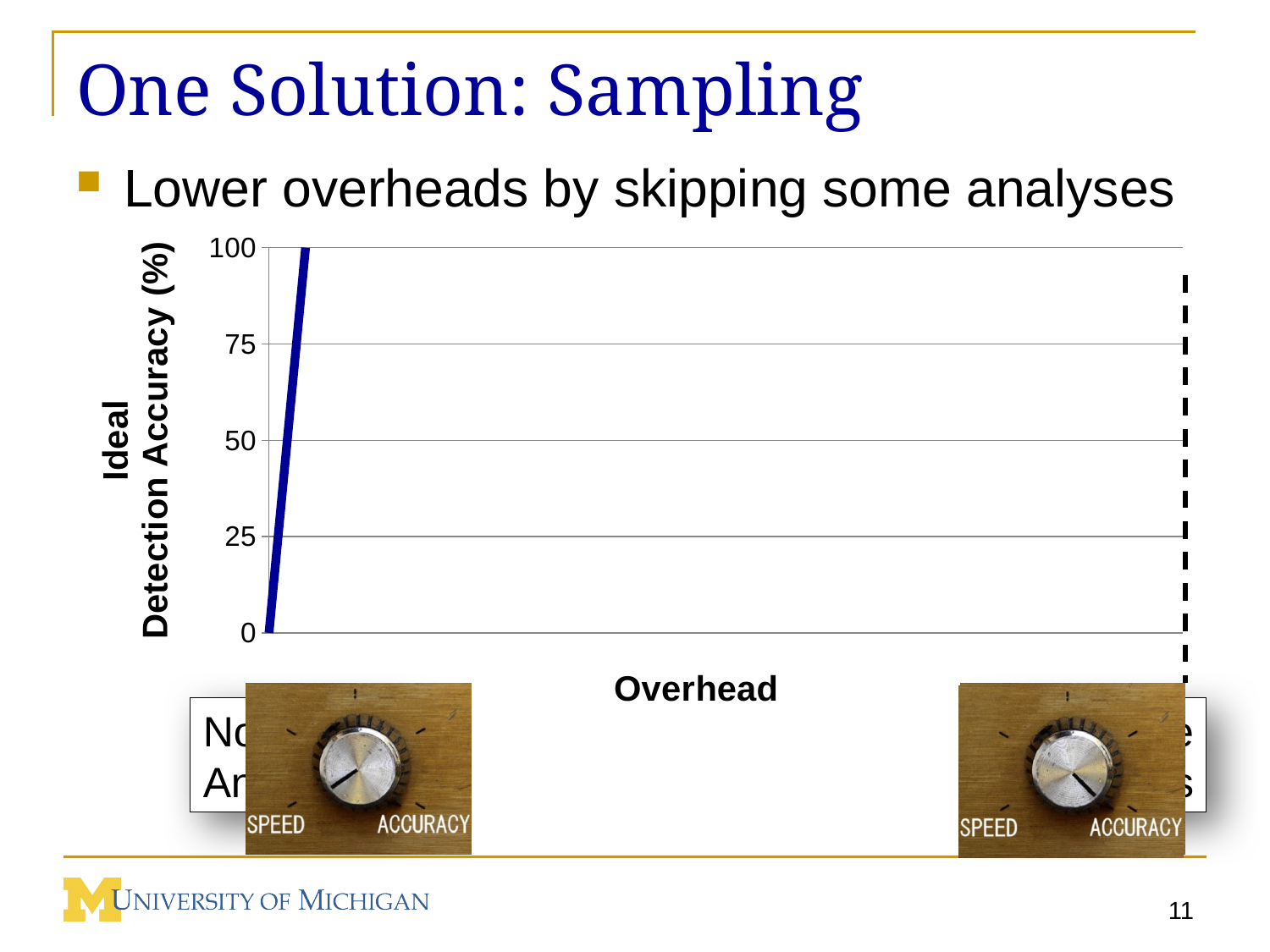
What kind of chart is shown on the slide? line chart What is the label of the x axis of the chart? Overhead What is the highest value shown on the y axis of the chart? 100 Does the plotted line rise or fall as overhead increases along the x axis? rise What is the interval between consecutive tick labels on the y axis? 25 At its left end, is the plotted line's value greater or less than 25? less How many tick labels are shown on the y axis of the chart? 5 At its right end, is the plotted line's value greater or less than 75? greater What is the label of the y axis of the chart? Ideal Detection Accuracy (%) What is the lowest value shown on the y axis of the chart? 0